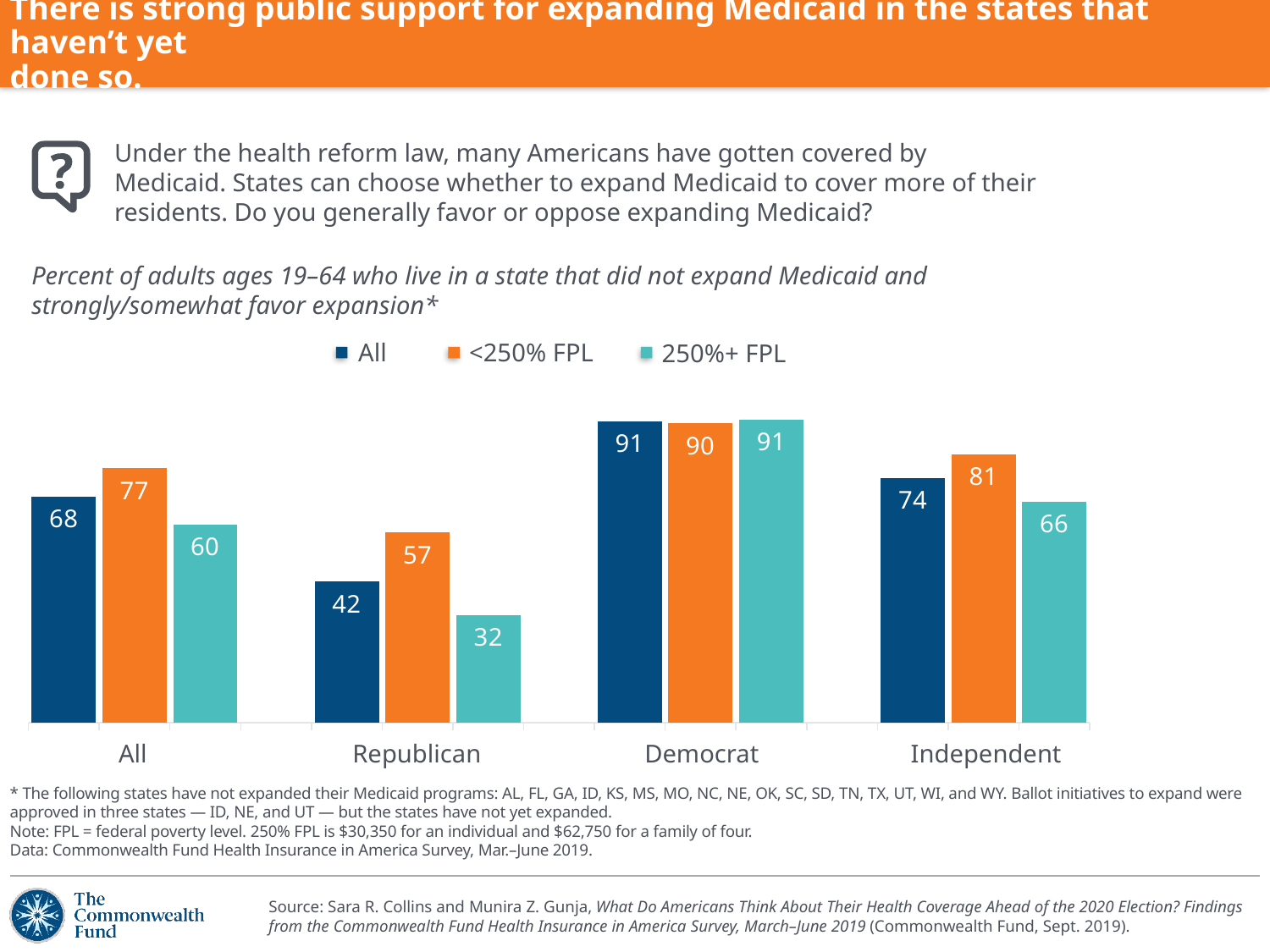
How many series does the legend list? 3 Which category has the highest value for the <250% FPL series? Democrat What is the value for the All series in the Independent category? 74 What is the difference between the <250% FPL and 250%+ FPL values in the Independent category? 15 Which series is shown in orange in the legend? <250% FPL Which is larger in the All category: the <250% FPL value or the 250%+ FPL value? <250% FPL How many categories are shown on the x axis? 4 What is the value for the <250% FPL series in the Republican category? 57 Which category has the lowest value for the 250%+ FPL series? Republican What is the value for the 250%+ FPL series in the All category? 60 What kind of chart is shown on the slide? Bar chart What is the difference between the All values for Democrat and Republican? 49